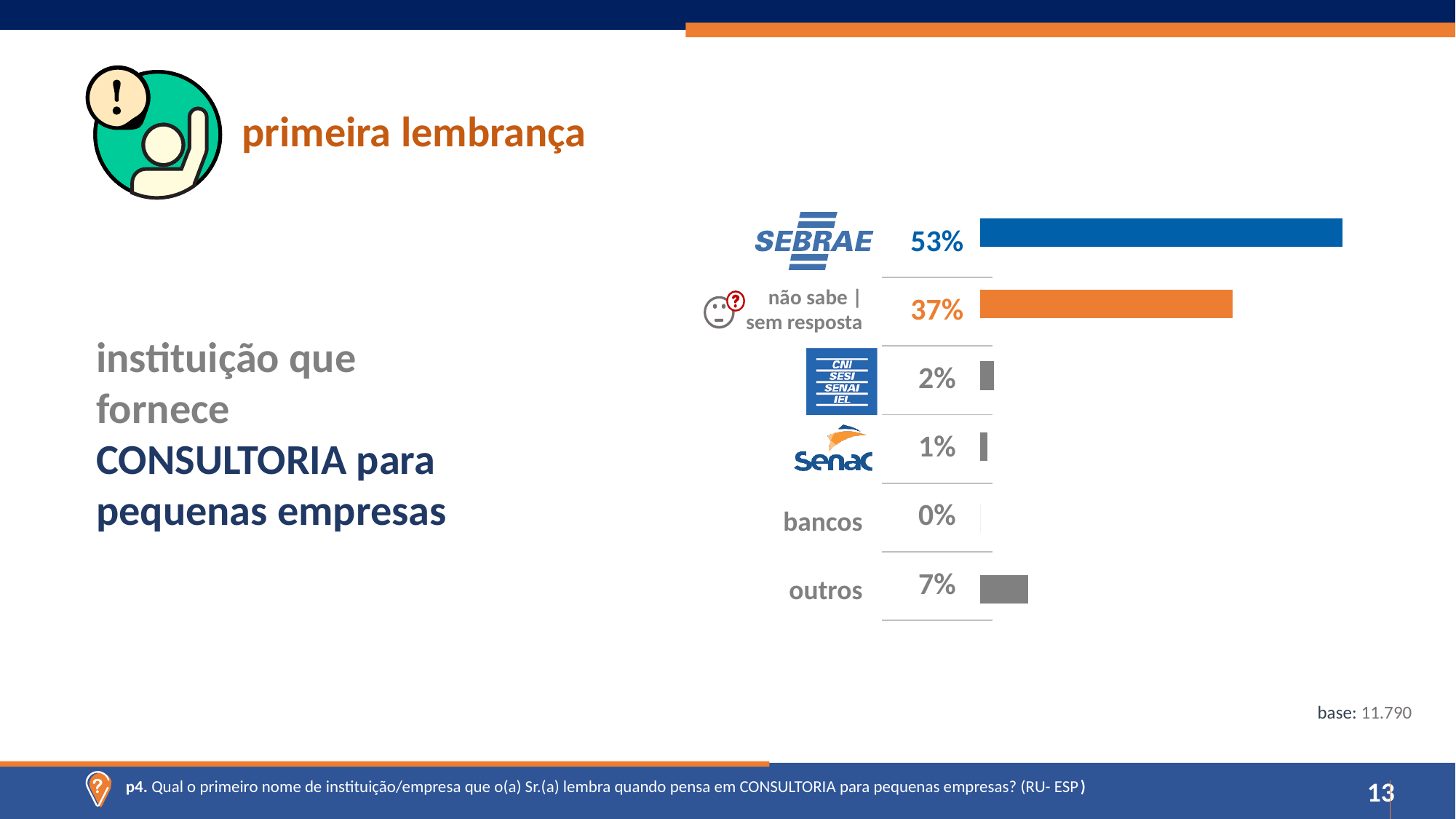
What percentage is shown for "outros"? 7% What value is shown for Senac? 1% What is the base (number of respondents) shown on the slide? 11.790 How many categories are shown in the chart? 6 Which is larger: the value for "outros" or the value for CNI/SESI/SENAI/IEL? outros Which category has the highest value in the chart? SEBRAE Which category has the lowest value in the chart? bancos What percentage of respondents named SEBRAE as the first institution they remember for consulting for small businesses? 53% What is the difference between the SEBRAE value and the "não sabe | sem resposta" value? 16 percentage points What value is shown for "bancos"? 0% What is the value shown for "não sabe | sem resposta"? 37% What kind of chart is shown on the slide? Bar chart